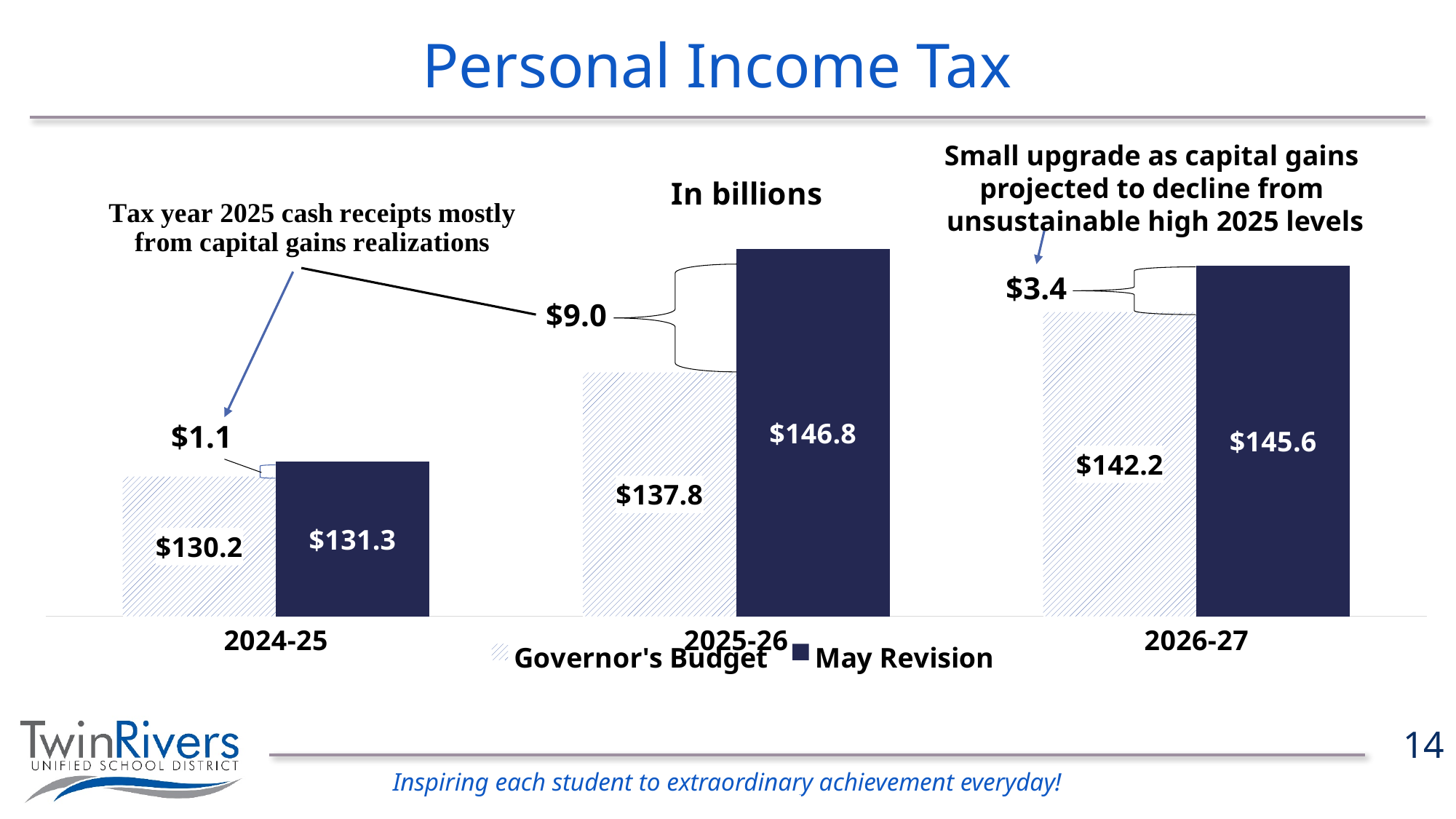
What is the May Revision value for 2025-26? $146.8 What kind of chart is shown on the slide? Bar chart Which year has the lowest Governor's Budget value? 2024-25 How many years are shown on the x axis? 3 What is the May Revision value for 2024-25? $131.3 What is the difference between the May Revision and Governor's Budget values for 2026-27? $3.4 How many series does the legend list? 2 Which is larger for 2026-27, the Governor's Budget value or the May Revision value? May Revision Which year has the highest May Revision value? 2025-26 What is the Governor's Budget value for 2026-27? $142.2 What is the Governor's Budget value for 2024-25? $130.2 What is the difference between the May Revision and Governor's Budget values for 2025-26? $9.0